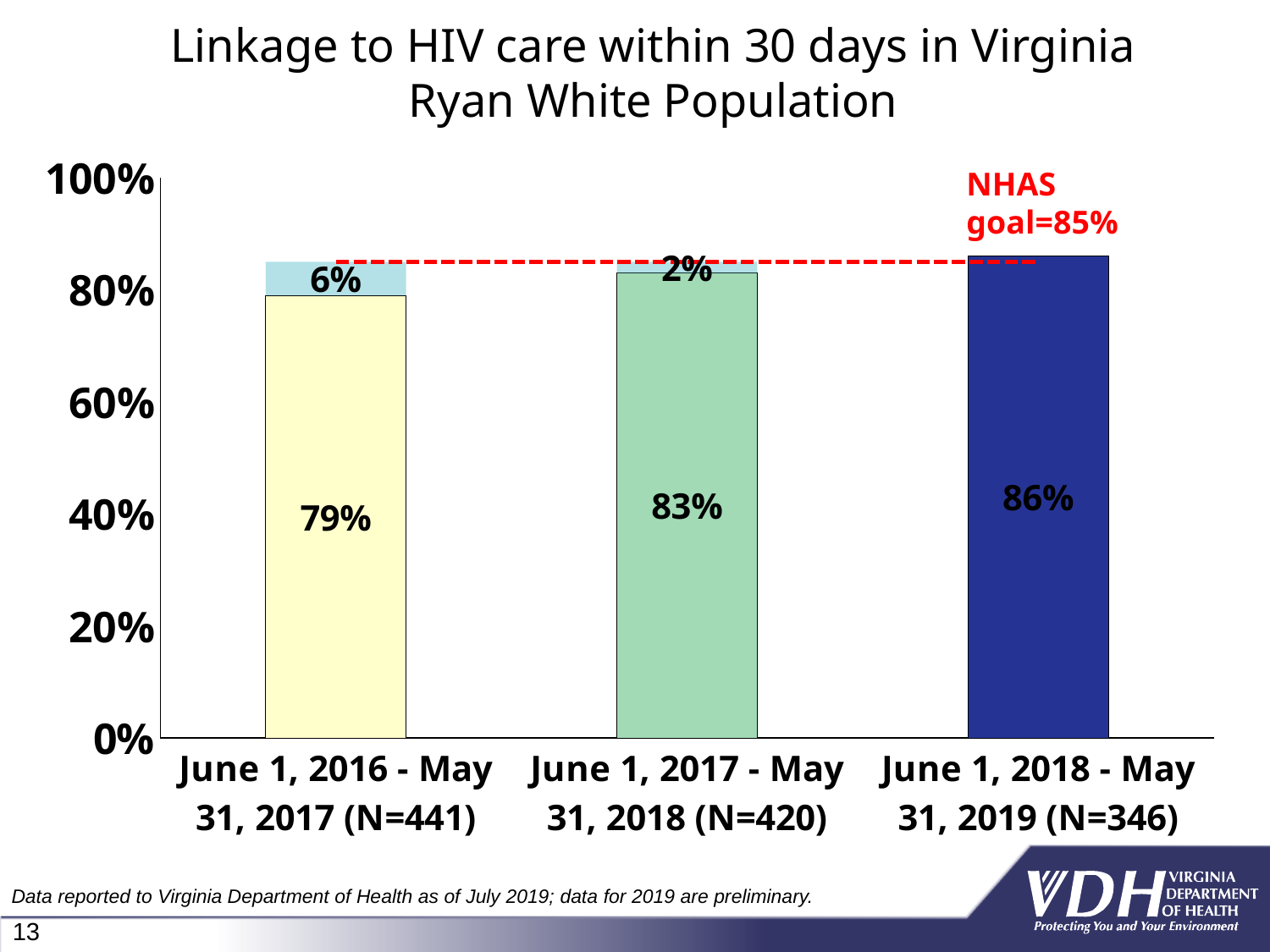
What is the linkage to HIV care percentage for June 1, 2017 - May 31, 2018 (N=420)? 83% What is the linkage to HIV care percentage for June 1, 2016 - May 31, 2017 (N=441)? 79% Which is larger, the linkage percentage for June 1, 2017 - May 31, 2018 or for June 1, 2016 - May 31, 2017? June 1, 2017 - May 31, 2018 What kind of chart is shown on the slide? bar chart Which period has the highest linkage to HIV care percentage? June 1, 2018 - May 31, 2019 (N=346) How many time periods are shown on the x axis? 3 What is the difference between the linkage percentage for June 1, 2018 - May 31, 2019 and June 1, 2016 - May 31, 2017? 7% What is the linkage to HIV care percentage for June 1, 2018 - May 31, 2019 (N=346)? 86% Which period has the lowest linkage to HIV care percentage? June 1, 2016 - May 31, 2017 (N=441) Do the linkage to HIV care percentages rise or fall across the periods from left to right? rise What is the NHAS goal shown by the red dashed line? 85% Is the linkage percentage for June 1, 2016 - May 31, 2017 greater or less than 80%? less